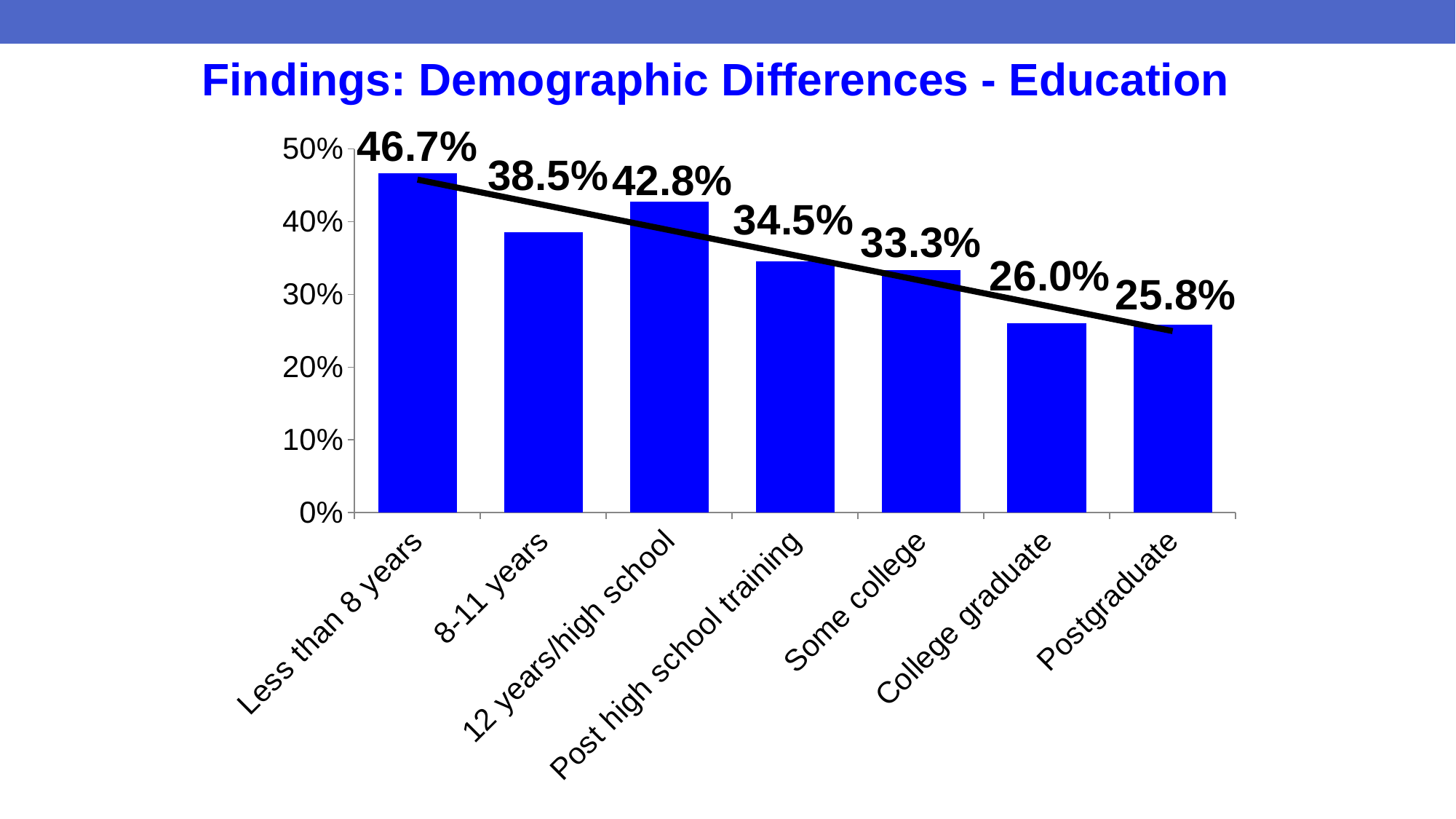
What is the value for Some college? 33.3% What is the difference between the values for Less than 8 years and Postgraduate? 20.9% Which education category has the highest value? Less than 8 years What is the value for 12 years/high school? 42.8% What kind of chart is shown on the slide? Bar chart What is the value for Postgraduate? 25.8% What is the difference between the values for 12 years/high school and 8-11 years? 4.3% What is the value for Less than 8 years? 46.7% Which is larger, the value for 8-11 years or the value for Post high school training? 8-11 years How many education categories are shown in the chart? 7 Which education category has the lowest value? Postgraduate What is the title of the slide? Findings: Demographic Differences - Education